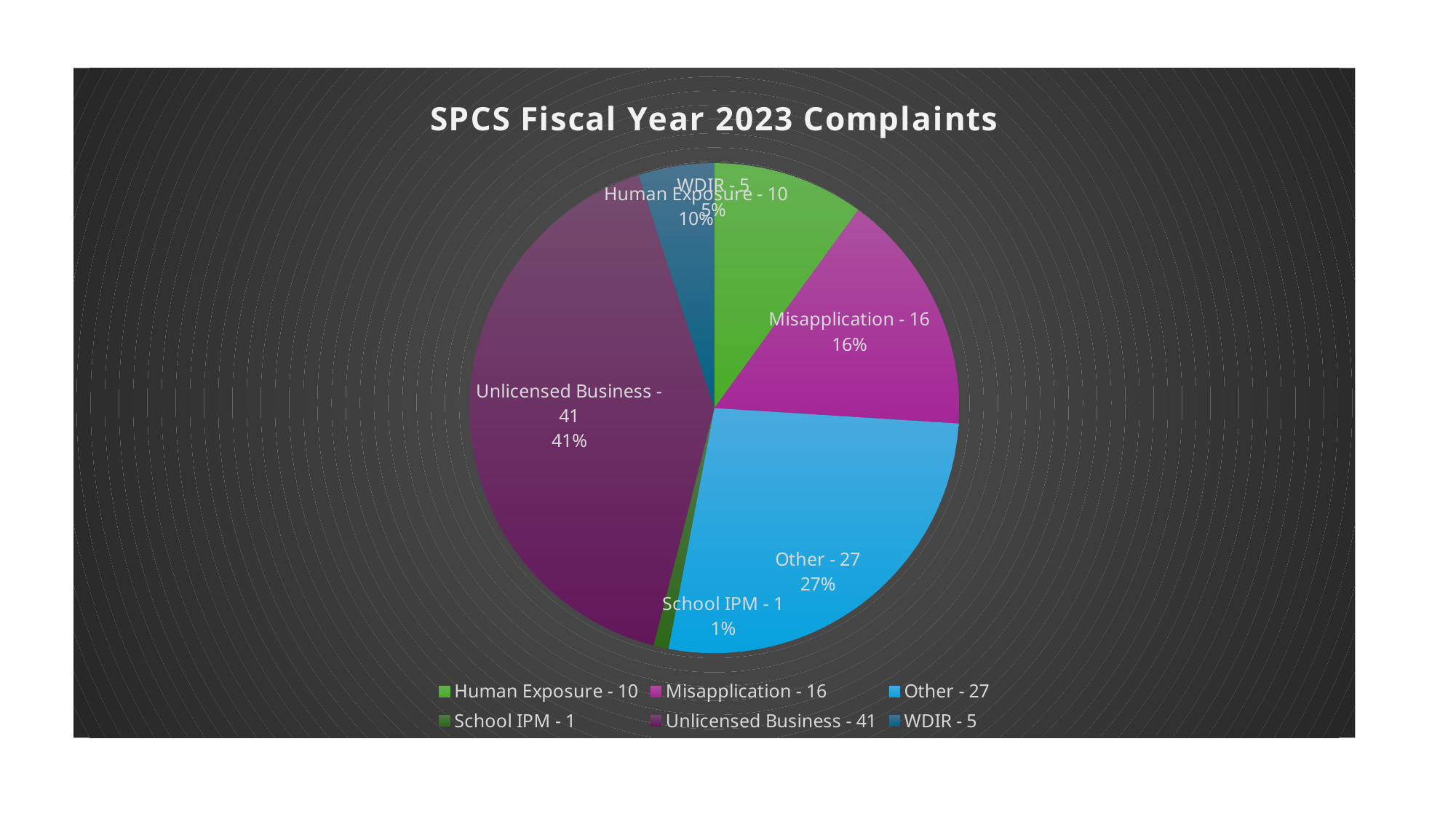
Which category has the largest slice? Unlicensed Business How many entries does the legend list? 6 How many slices does the pie chart have? 6 What percentage share does the Misapplication slice have? 16% Which is larger, the Human Exposure slice or the WDIR slice? Human Exposure What percentage share does the Unlicensed Business slice have? 41% Which category has the smallest slice? School IPM What percentage share does the School IPM slice have? 1% What is the difference in percentage points between the Other slice and the Misapplication slice? 11% What kind of chart is shown on the slide? pie chart What is the title of the chart? SPCS Fiscal Year 2023 Complaints